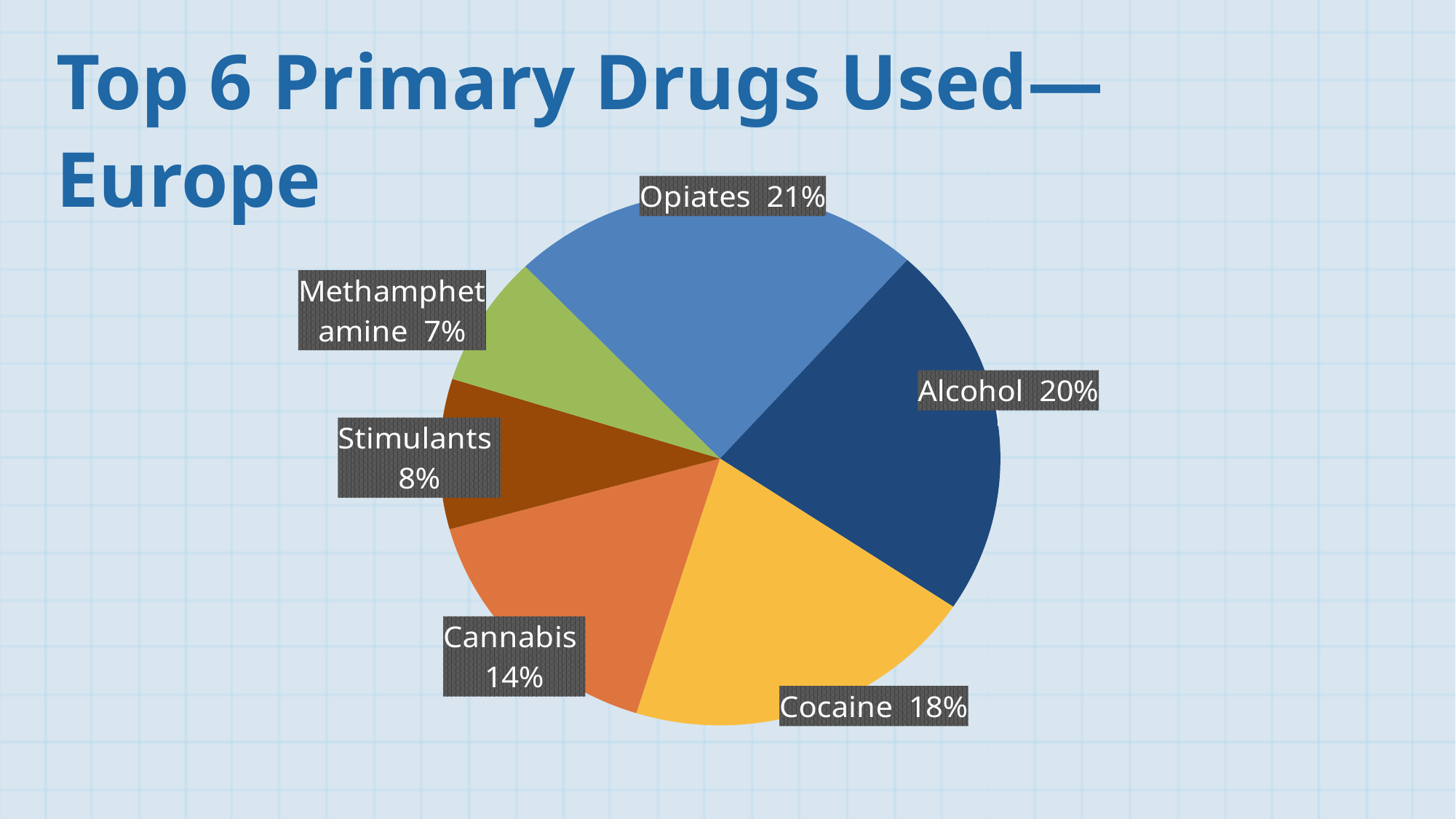
What type of chart is shown on the slide? Pie chart How many slices does the pie chart have? 6 What percentage of the pie chart is Opiates? 21% What is the difference in percentage points between Cannabis and Methamphetamine? 7 Which drug has the smallest slice of the pie chart? Methamphetamine Which has a larger share, Cocaine or Cannabis? Cocaine Which has a larger share, Stimulants or Methamphetamine? Stimulants What is the title of the slide? Top 6 Primary Drugs Used—Europe Which drug has the largest slice of the pie chart? Opiates What is the value shown for Stimulants? 8% What percentage does the Cannabis slice represent? 14% What is the difference in percentage points between Alcohol and Cocaine? 2